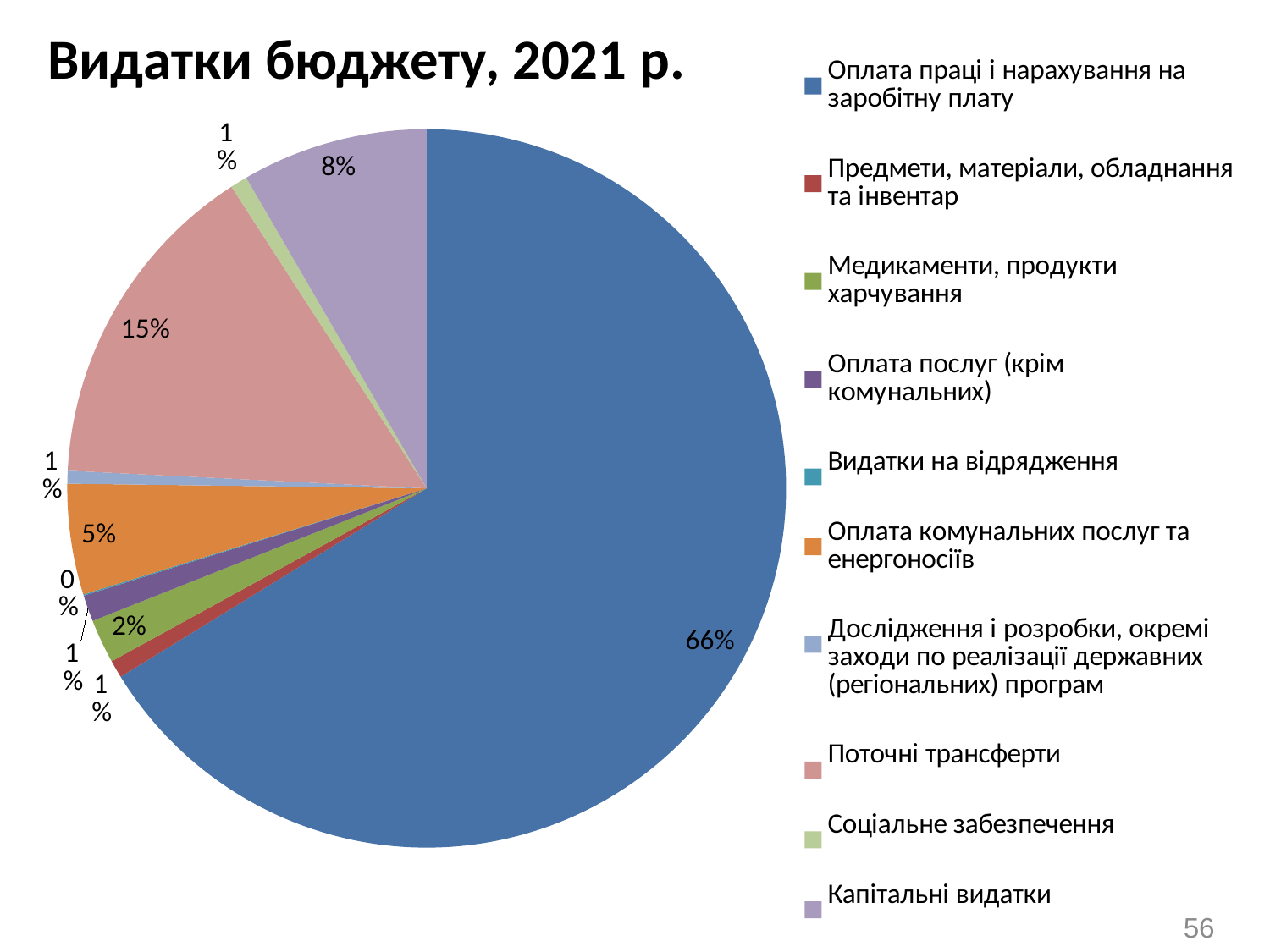
What is the title of the chart? Видатки бюджету, 2021 р. Which is larger: the share for "Поточні трансферти" or the share for "Капітальні видатки"? Поточні трансферти What share of the pie is "Оплата праці і нарахування на заробітну плату"? 66% What share of the pie is "Оплата комунальних послуг та енергоносіїв"? 5% What share of the pie is "Видатки на відрядження"? 0% Which category has the largest share of the pie? Оплата праці і нарахування на заробітну плату What is the difference in percentage points between the share for "Оплата праці і нарахування на заробітну плату" and the share for "Поточні трансферти"? 51 How many categories does the legend list? 10 What type of chart is shown on the slide? pie chart